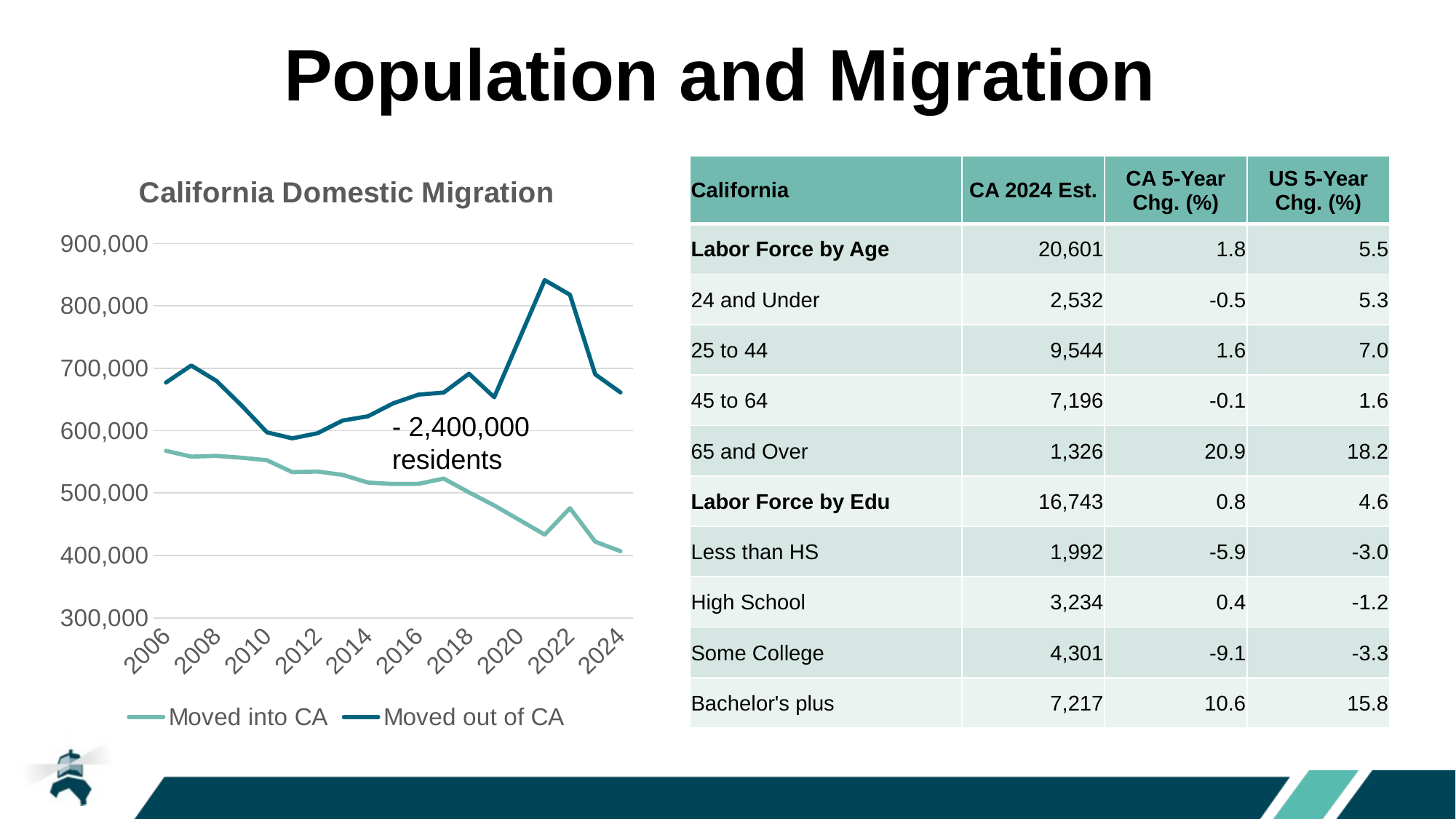
What are the two series named in the legend of the California Domestic Migration chart? Moved into CA and Moved out of CA What kind of chart is the California Domestic Migration chart? line chart What annotation text is printed on the California Domestic Migration chart? - 2,400,000 residents In the California Domestic Migration chart, which series is higher in 2024, Moved into CA or Moved out of CA? Moved out of CA In the California Domestic Migration chart, does the Moved into CA series generally rise or fall from 2006 to 2024? fall In the California Domestic Migration chart, is the highest value of the Moved out of CA series greater or less than 800,000? greater How many series does the legend of the California Domestic Migration chart list? 2 In the California Domestic Migration chart, is the value for Moved out of CA in 2024 greater or less than 600,000? greater In the California Domestic Migration chart, is the value for Moved out of CA in 2006 greater or less than 600,000? greater In the California Domestic Migration chart, in which year is the Moved into CA series at its lowest? 2024